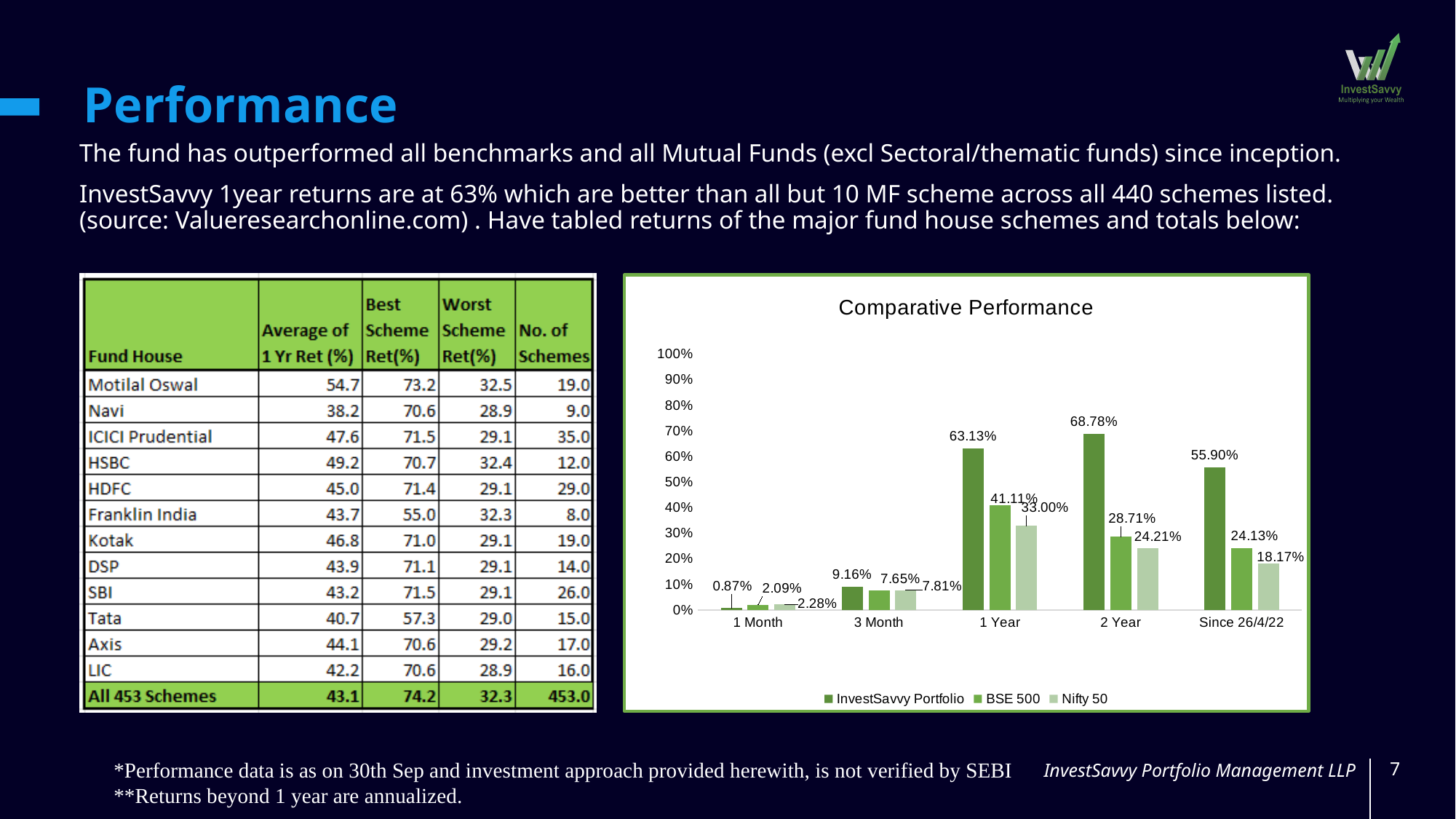
What is the Nifty 50 value for Since 26/4/22 in the Comparative Performance chart? 18.17% What is the InvestSavvy Portfolio value for 1 Year in the Comparative Performance chart? 63.13% Is the InvestSavvy Portfolio value for Since 26/4/22 greater or less than 50% in the Comparative Performance chart? greater In which category is the Nifty 50 value lowest in the Comparative Performance chart? 1 Month What is the title of the chart on the slide? Comparative Performance What is the difference between the InvestSavvy Portfolio and BSE 500 values for 2 Year in the Comparative Performance chart? 40.07% What type of chart is the Comparative Performance chart? bar chart What is the BSE 500 value for 2 Year in the Comparative Performance chart? 28.71% How many series does the legend of the Comparative Performance chart list? 3 In which category does the InvestSavvy Portfolio reach its highest value in the Comparative Performance chart? 2 Year How many categories are shown on the x axis of the Comparative Performance chart? 5 For 1 Month in the Comparative Performance chart, which is larger: the InvestSavvy Portfolio value or the Nifty 50 value? Nifty 50